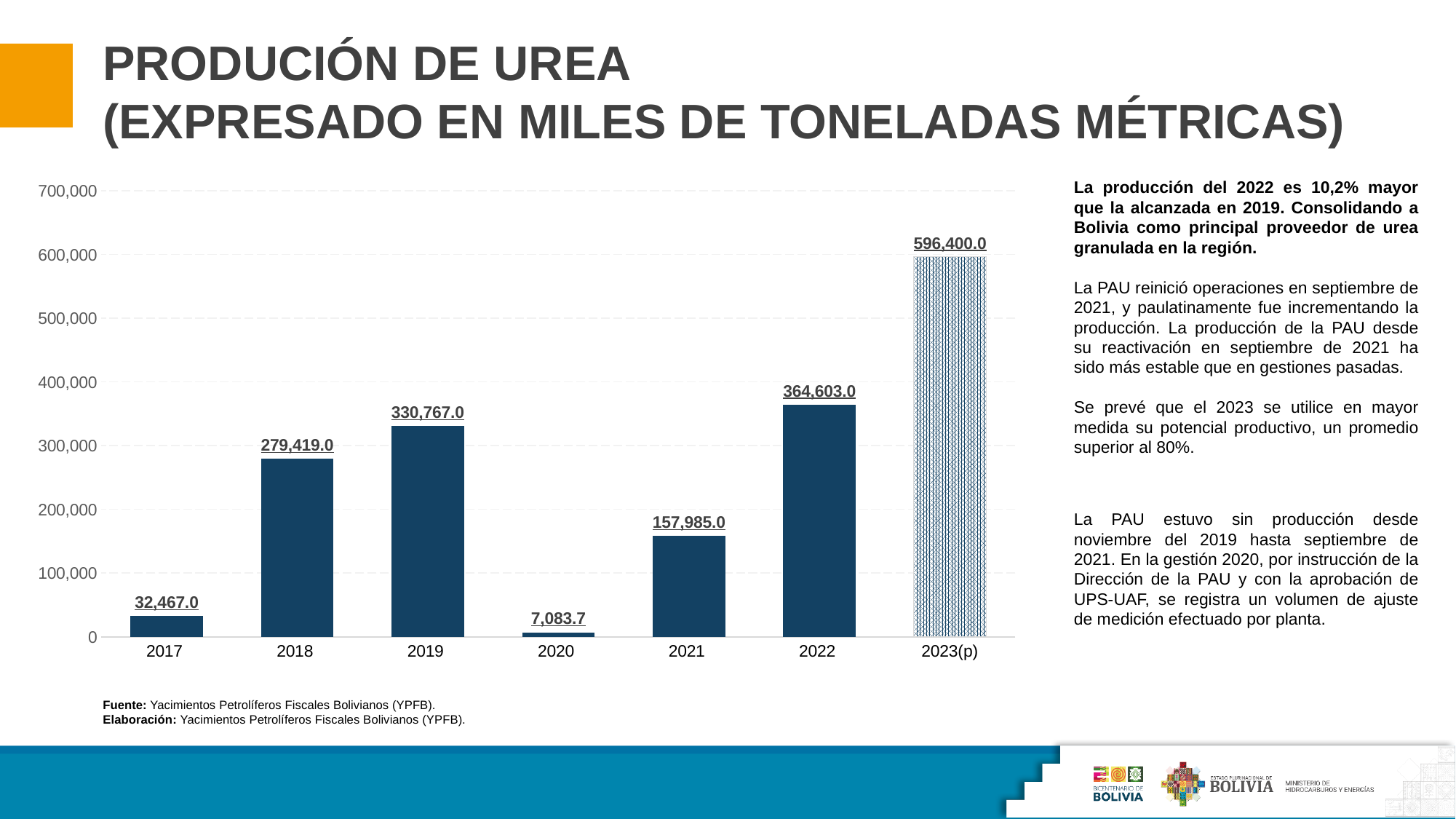
How many years are shown on the x axis of the chart? 7 What is the urea production value shown for 2019? 330,767.0 What is the difference between the urea production values for 2023(p) and 2022? 231,797.0 Does the urea production value rise or fall from 2021 to 2022? Rise Which year has a larger urea production value, 2018 or 2021? 2018 Which year has the highest urea production value in the chart? 2023(p) What is the difference between the urea production values for 2022 and 2019? 33,836.0 What is the urea production value shown for 2021? 157,985.0 What kind of chart is used to show urea production? Bar chart Is the urea production value for 2022 greater or less than 300,000? greater What is the projected urea production value shown for 2023(p)? 596,400.0 Which year has the lowest urea production value in the chart? 2020